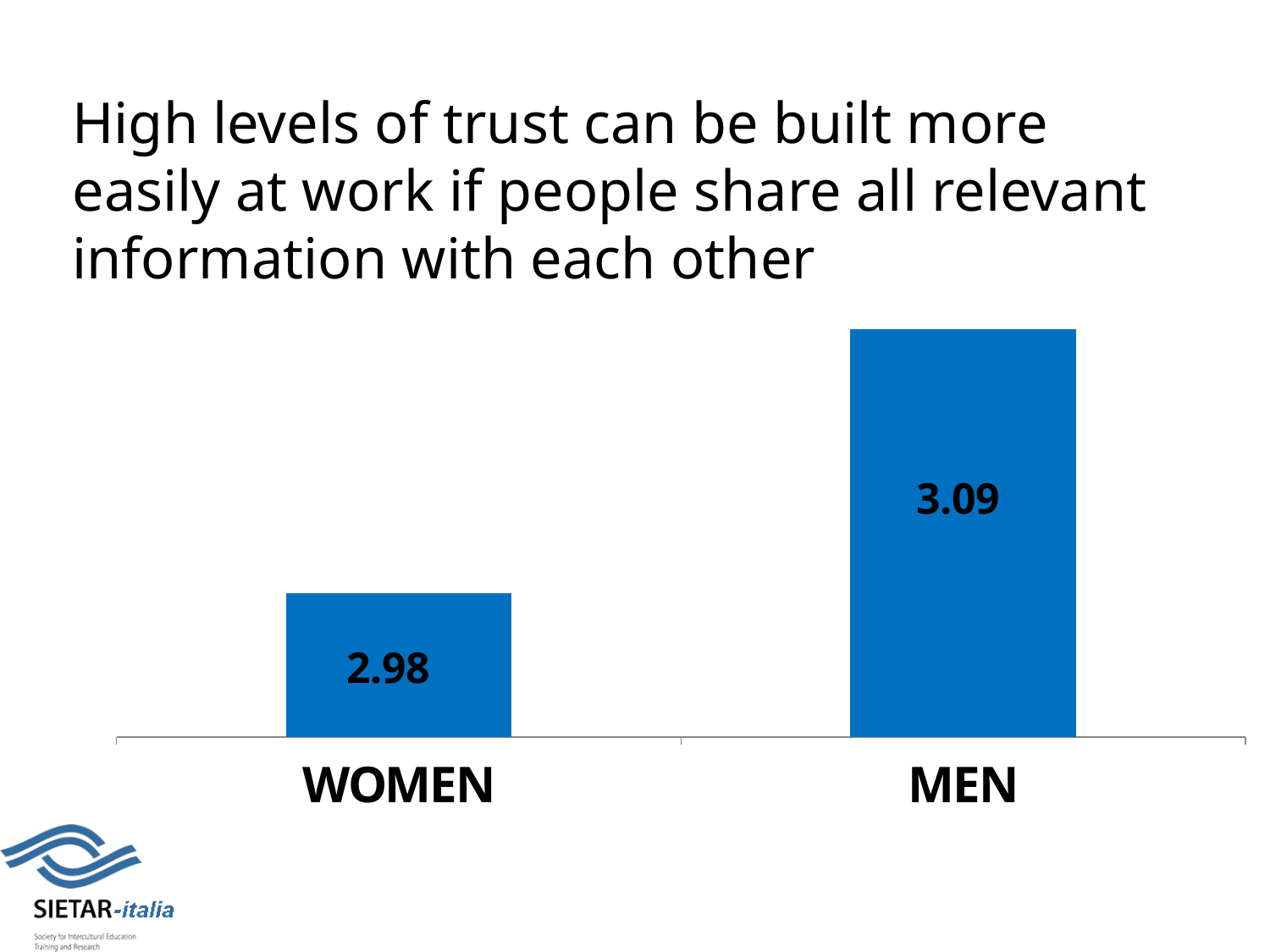
What kind of chart is shown on the slide? Bar chart Do the values rise or fall from WOMEN to MEN? Rise What is the value for MEN? 3.09 What is the value for WOMEN? 2.98 Which is larger, the value for WOMEN or the value for MEN? MEN Which category has the lowest value? WOMEN Which category has the highest value? MEN What is the difference between the values for MEN and WOMEN? 0.11 What is the title text above the chart? High levels of trust can be built more easily at work if people share all relevant information with each other How many categories are shown in the chart? 2 What colour are the bars in the chart? Blue